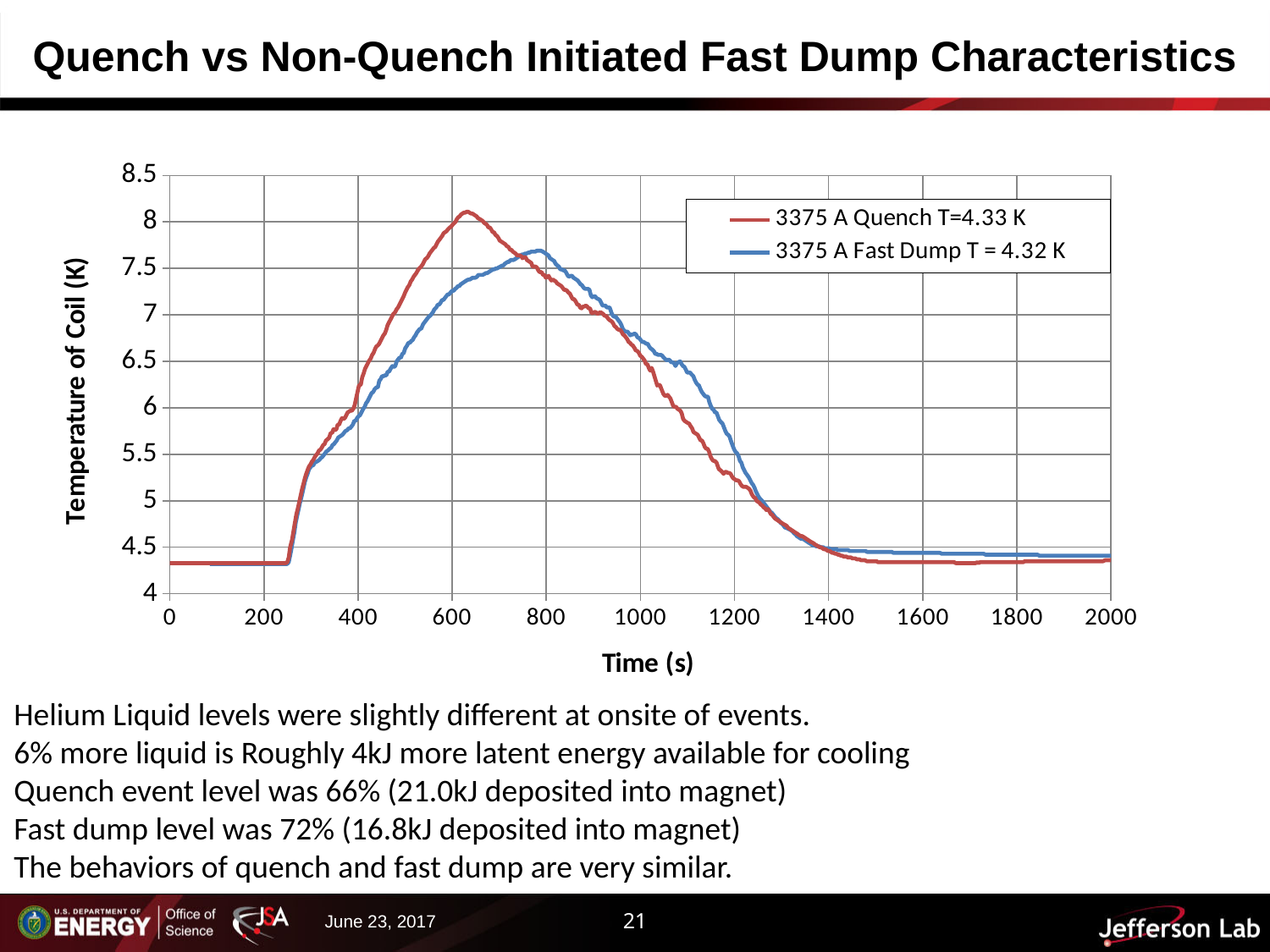
Which series reaches its peak later in time, 3375 A Quench T=4.33 K or 3375 A Fast Dump T = 4.32 K? 3375 A Fast Dump T = 4.32 K Is the value of the 3375 A Fast Dump T = 4.32 K series at 0 s greater or less than 4.5? less How many series does the legend list? 2 Which series has the higher value at 1100 s, 3375 A Quench T=4.33 K or 3375 A Fast Dump T = 4.32 K? 3375 A Fast Dump T = 4.32 K Is the value of the 3375 A Fast Dump T = 4.32 K series at 600 s greater or less than 7.5? less What is the label of the y axis? Temperature of Coil (K) Is the value of the 3375 A Quench T=4.33 K series at 600 s greater or less than 7.5? greater What kind of chart is shown on the slide? line chart What is the label of the x axis? Time (s) Which series reaches the higher peak temperature, 3375 A Quench T=4.33 K or 3375 A Fast Dump T = 4.32 K? 3375 A Quench T=4.33 K Does the 3375 A Fast Dump T = 4.32 K series rise or fall between 800 s and 1400 s? fall